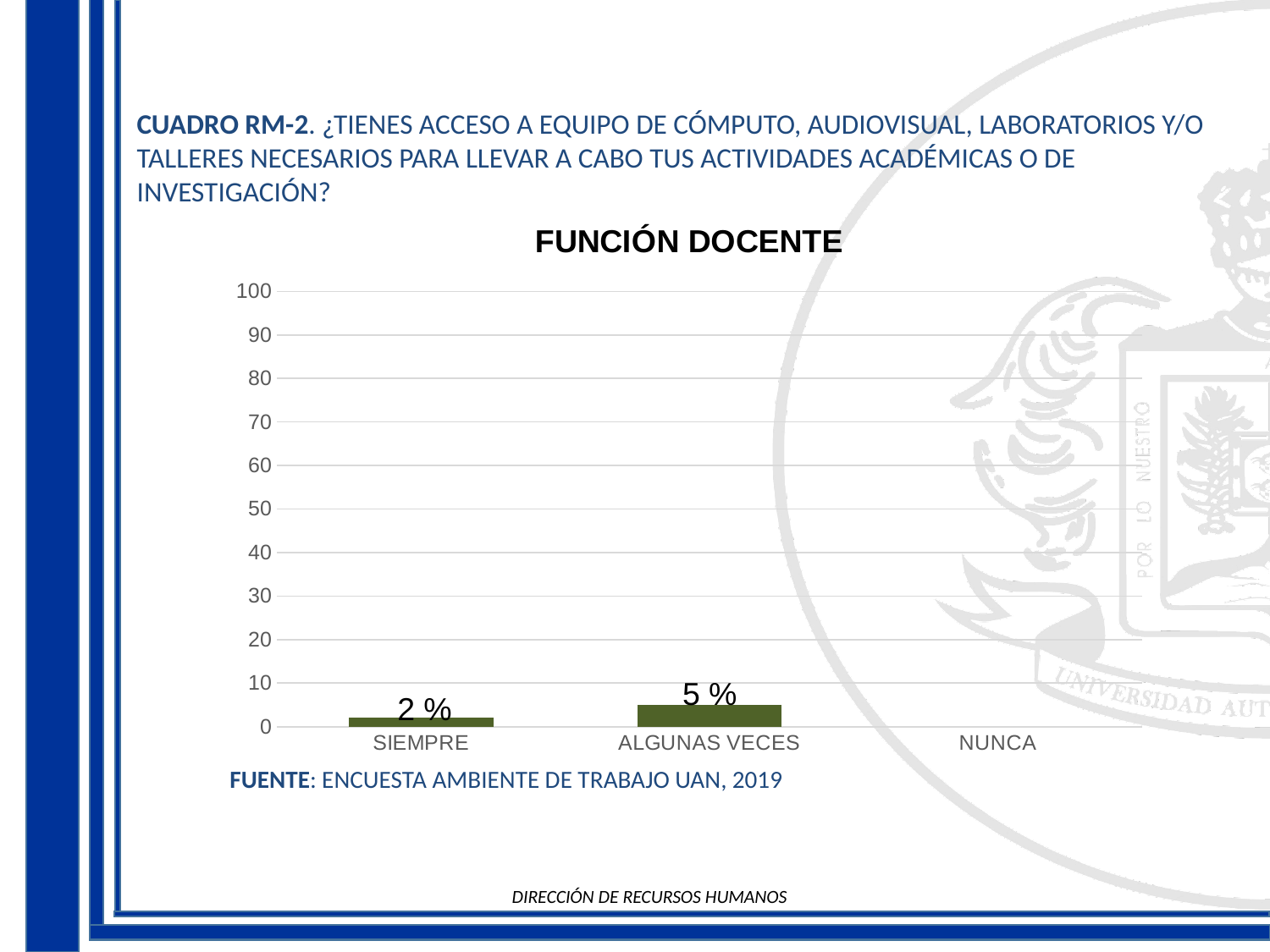
Which is larger, the value for SIEMPRE or the value for ALGUNAS VECES? ALGUNAS VECES Which category has the highest value? ALGUNAS VECES What kind of chart is shown on the slide? bar chart Is the value for SIEMPRE greater or less than 10? less What is the difference between the values for ALGUNAS VECES and SIEMPRE? 3 % What is the value for ALGUNAS VECES? 5 % Is the value for ALGUNAS VECES greater or less than 10? less What is the highest value shown on the y axis? 100 How many categories are shown on the x axis? 3 What is the title of the chart? FUNCIÓN DOCENTE What is the value for SIEMPRE? 2 %